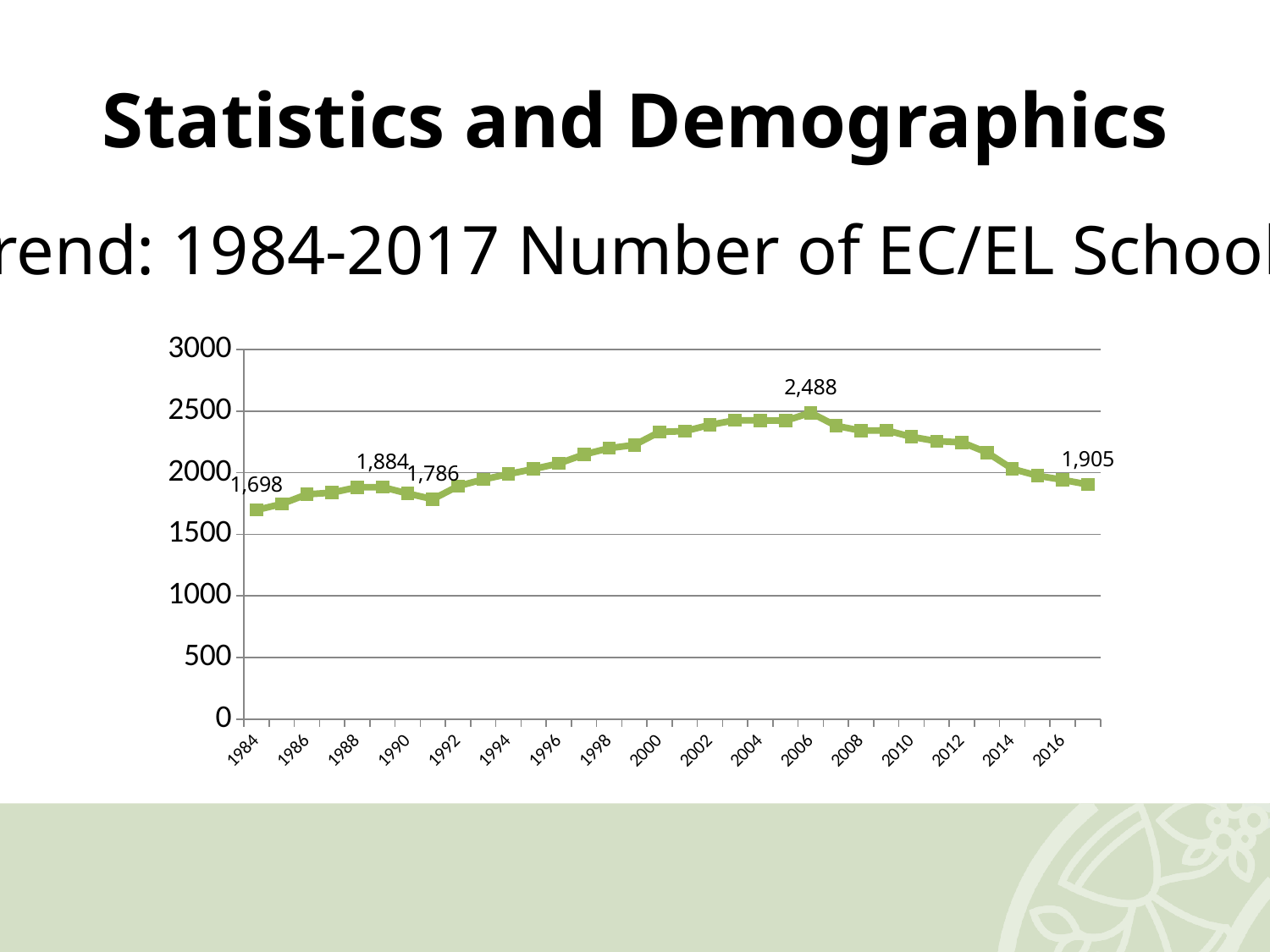
What value is labelled at the final data point (2017) of the line? 1,905 Is the value for 2000 greater or less than 2000? greater What is the number of EC/EL schools in 1984? 1,698 Does the number of EC/EL schools rise or fall between 2006 and 2017? fall What is the number of EC/EL schools in 2006? 2,488 How much did the number of schools fall from the 2006 peak to the 2017 value? 583 In which year does the number of EC/EL schools reach its highest point? 2006 What is the difference between the 2006 value and the 1984 value? 790 Which year has the larger value, 1984 or 2017? 2017 Is the value for 2012 greater or less than 2000? greater In which year is the number of EC/EL schools lowest? 1984 What kind of chart is shown on the slide? line chart